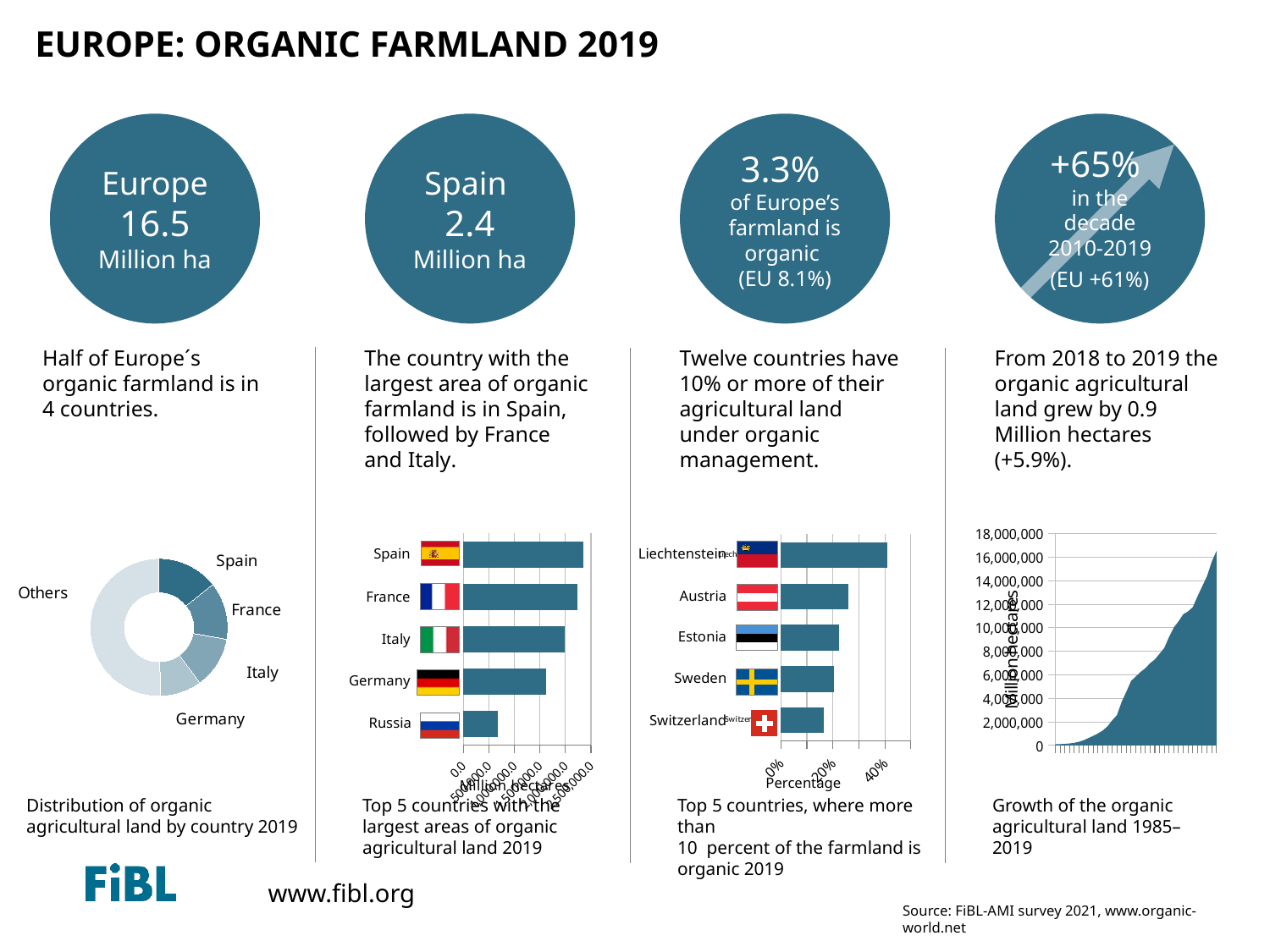
What kind of chart is the 'Distribution of organic agricultural land by country 2019' chart on the left of the slide? Pie (donut) chart In the 'Growth of the organic agricultural land 1985–2019' chart, do the values rise or fall over time? Rise In the 'Growth of the organic agricultural land 1985–2019' chart, is the final value greater or less than 14,000,000? greater What kind of chart is the 'Top 5 countries with the largest areas of organic agricultural land 2019' chart? Bar chart In the 'Distribution of organic agricultural land by country 2019' donut chart, which category has the largest slice? Others In the 'Top 5 countries with the largest areas of organic agricultural land 2019' chart, which country has the longest bar? Spain In the 'Top 5 countries with the largest areas of organic agricultural land 2019' chart, which has the larger value, Germany or Russia? Germany How many categories does the 'Distribution of organic agricultural land by country 2019' donut chart show? 5 In the 'Top 5 countries, where more than 10 percent of the farmland is organic 2019' chart, which country has the highest percentage? Liechtenstein In the 'Top 5 countries, where more than 10 percent of the farmland is organic 2019' chart, which country has the lowest percentage? Switzerland In the 'Top 5 countries, where more than 10 percent of the farmland is organic 2019' chart, is the value for Austria greater or less than 20%? greater In the 'Top 5 countries with the largest areas of organic agricultural land 2019' chart, which country has the shortest bar? Russia